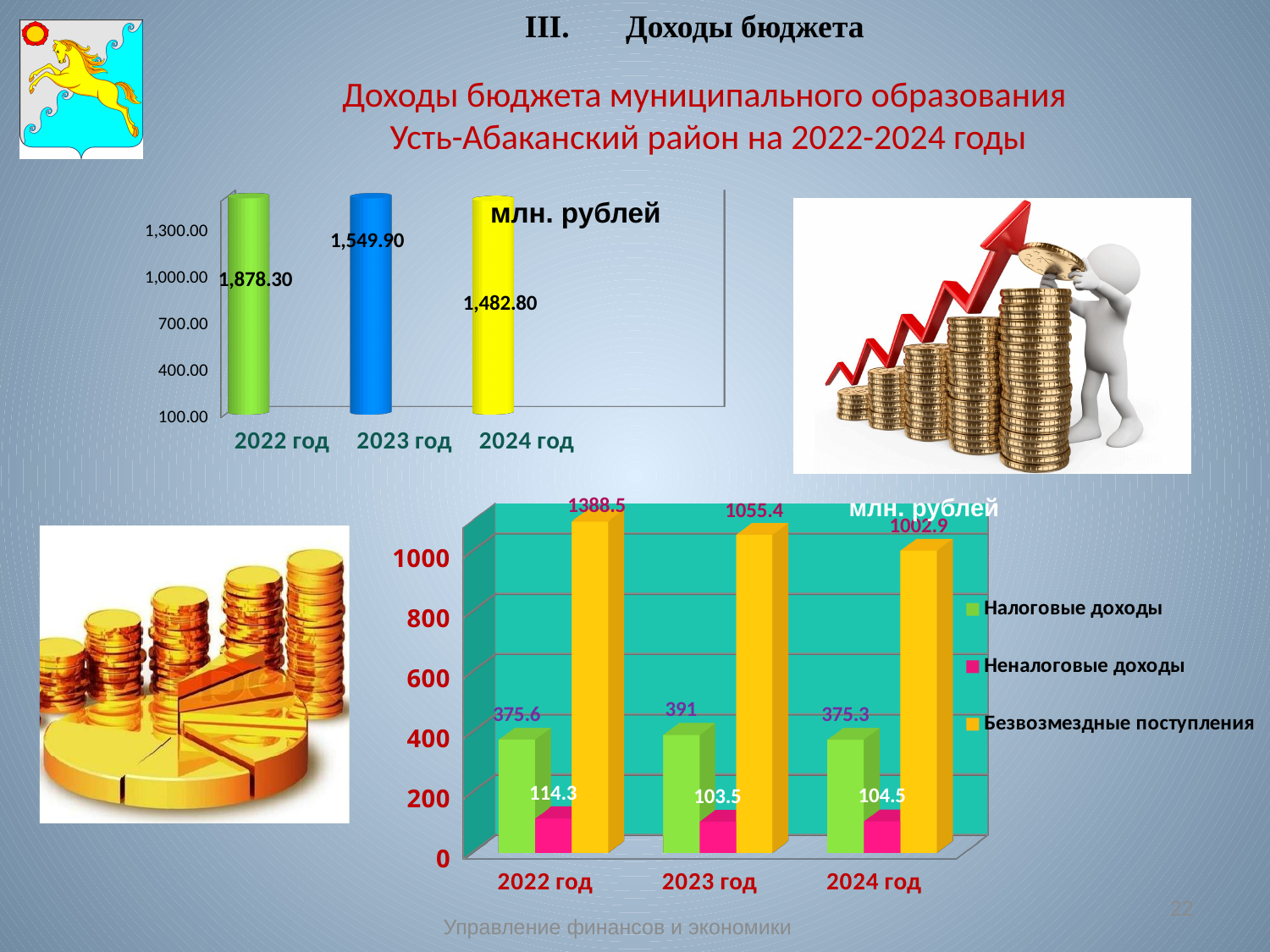
In the top chart, what is the difference between the values for 2022 год and 2023 год? 328.40 In the top chart, what is the value for 2024 год? 1,482.80 In the bottom chart, what is the value of Неналоговые доходы for 2023 год? 103.5 In the bottom chart, which is larger for 2024 год: Налоговые доходы or Неналоговые доходы? Налоговые доходы In the bottom chart, what is the value of Безвозмездные поступления for 2022 год? 1388.5 In the bottom chart, which year has the highest value of Налоговые доходы? 2023 год In the bottom chart, what is the difference between Безвозмездные поступления for 2023 год and 2024 год? 52.5 In the top chart, which year has the lowest value? 2024 год In the top chart, do the values rise or fall from 2022 год to 2024 год? fall In the top chart, what is the value for 2022 год? 1,878.30 How many series does the legend of the bottom chart list? 3 What type of chart is the bottom chart? bar chart